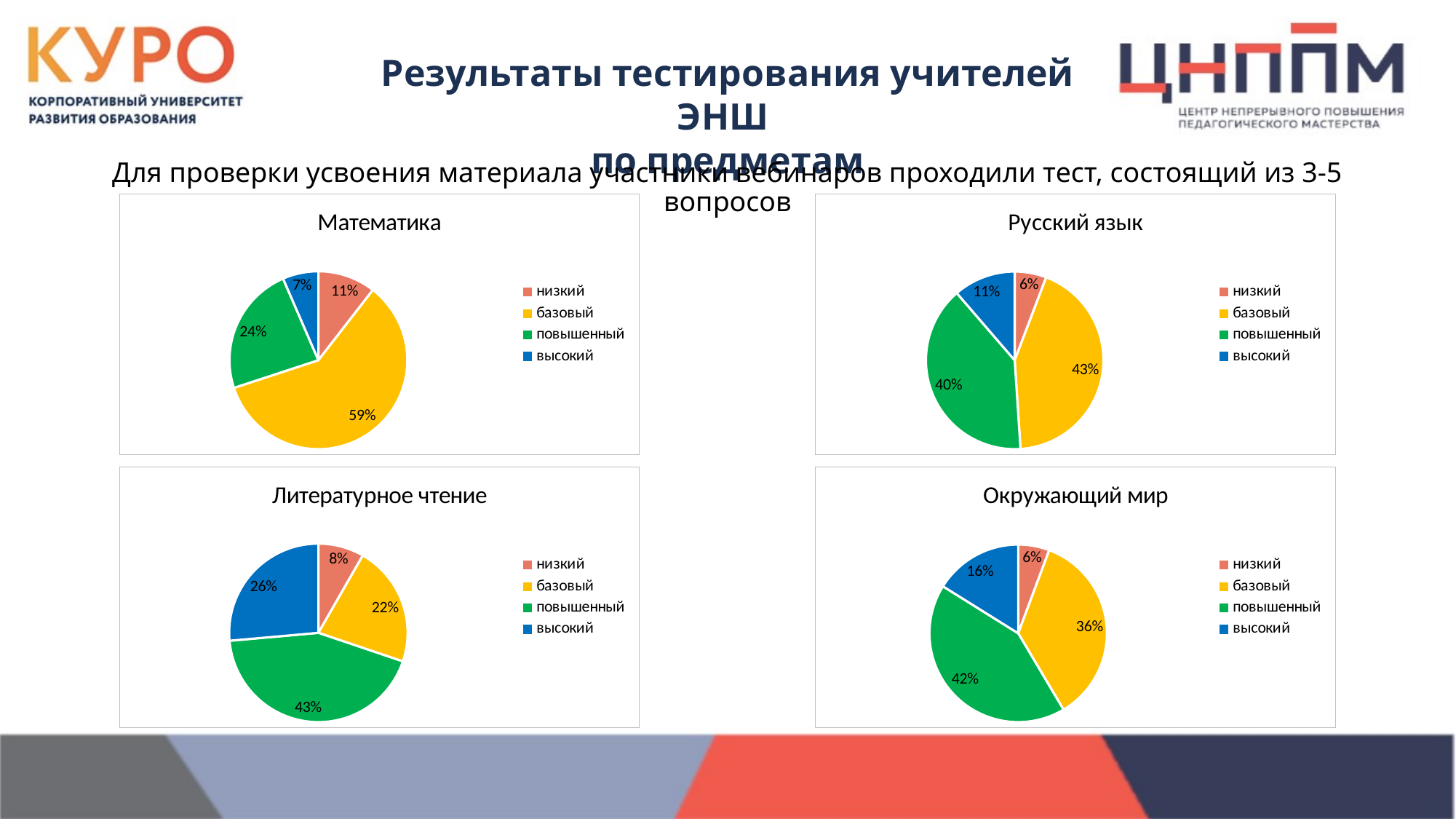
In the "Русский язык" chart, what is the difference between базовый and высокий? 32% In the "Математика" chart, which category has the smallest slice? высокий In the "Литературное чтение" chart, which colour represents высокий? blue In the "Окружающий мир" chart, what is the value for низкий? 6% In the "Литературное чтение" chart, which is larger, базовый or повышенный? повышенный How many categories does the legend of the "Окружающий мир" chart list? 4 In the "Окружающий мир" chart, what is the difference between повышенный and базовый? 6% In the "Математика" chart, what share is labelled for базовый? 59% In the "Литературное чтение" chart, what is the value for высокий? 26% What kind of chart is the "Математика" chart? pie chart In the "Русский язык" chart, what is the value for повышенный? 40% In the "Русский язык" chart, which category has the largest slice? базовый